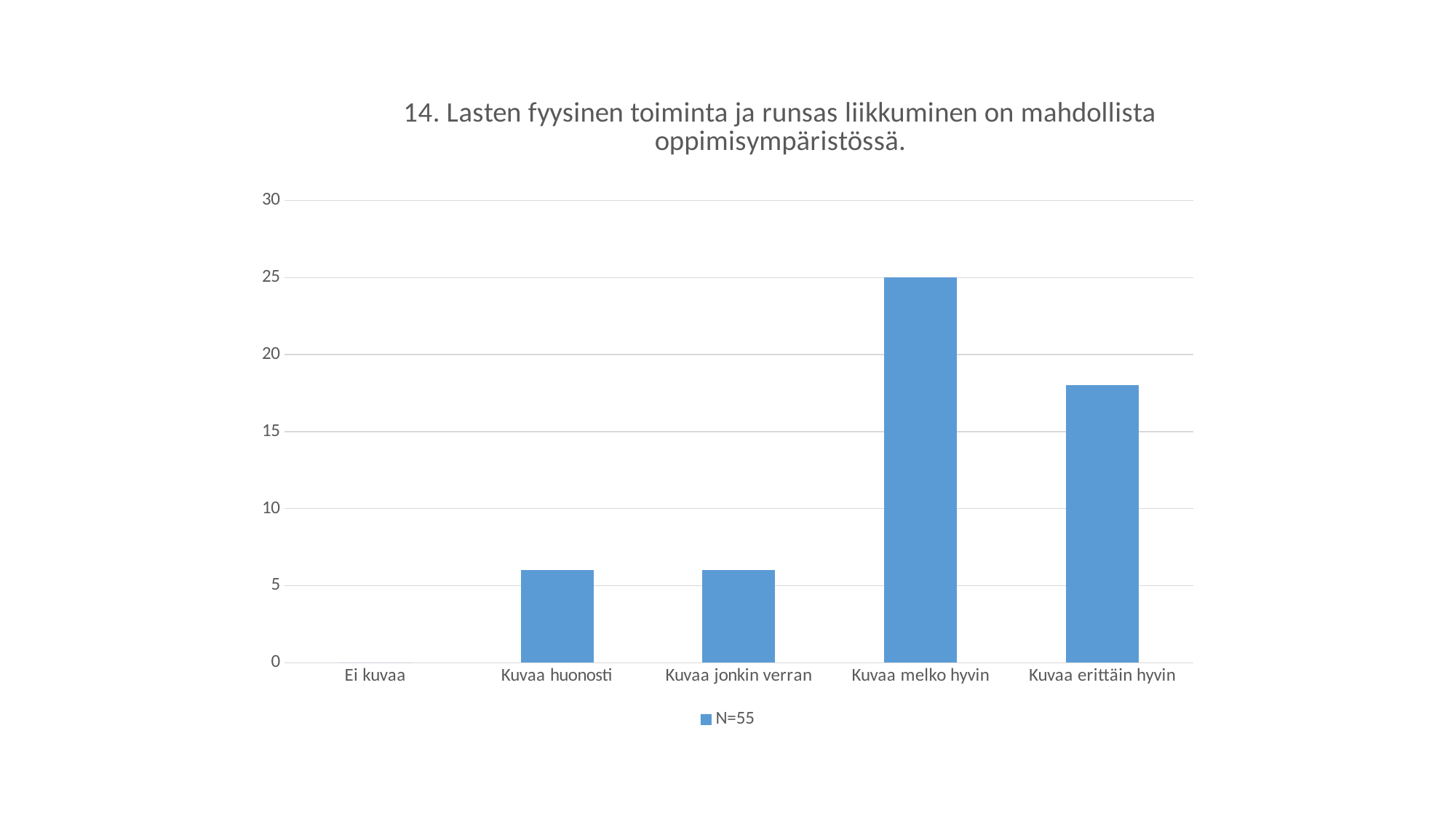
Is the value for Kuvaa huonosti greater or less than 10? less What is the value for Kuvaa melko hyvin? 25 How many series does the legend list? 1 Which category has the lowest value? Ei kuvaa Is the value for Kuvaa jonkin verran greater or less than 5? greater Is the value for Kuvaa erittäin hyvin greater or less than 15? greater What type of chart is shown on the slide? bar chart What is the legend entry for the series in the chart? N=55 What is the highest value shown on the y axis of the chart? 30 Which is larger, the value for Kuvaa melko hyvin or the value for Kuvaa erittäin hyvin? Kuvaa melko hyvin How many categories are shown on the x axis of the chart? 5 Which category has the highest value? Kuvaa melko hyvin